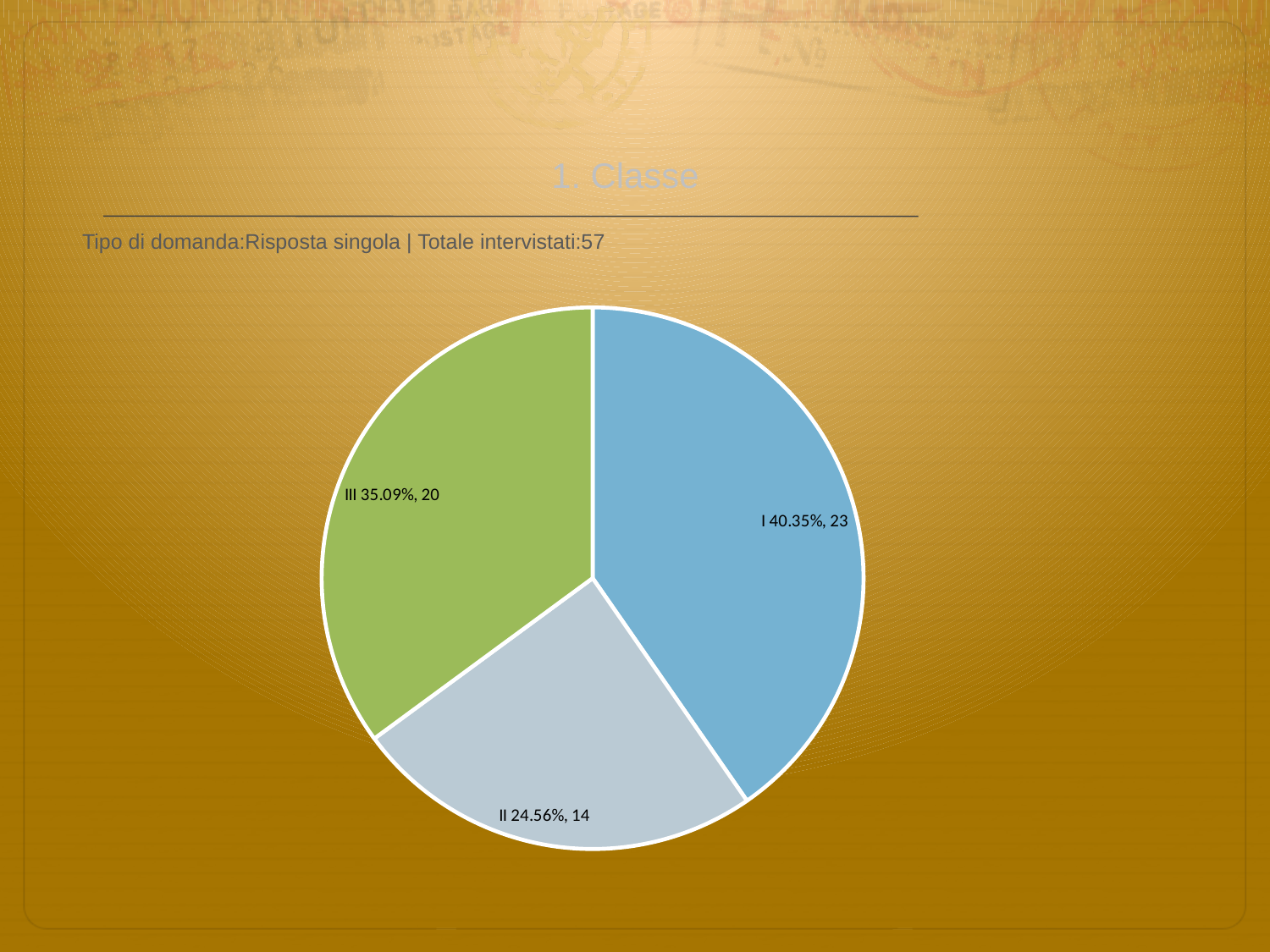
What kind of chart is shown on the slide? pie chart What is the total number of respondents stated on the slide? 57 What percentage share does class I have in the pie chart? 40.35% What colour is the slice for class III? green What is the difference in count between class I and class II? 9 What is the count for class III in the pie chart? 20 Which class has the largest slice in the pie chart? I Which class has the smallest slice in the pie chart? II What percentage share does class II have in the pie chart? 24.56% Which has a larger count, class III or class II? III What is the count for class I in the pie chart? 23 How many slices does the pie chart have? 3